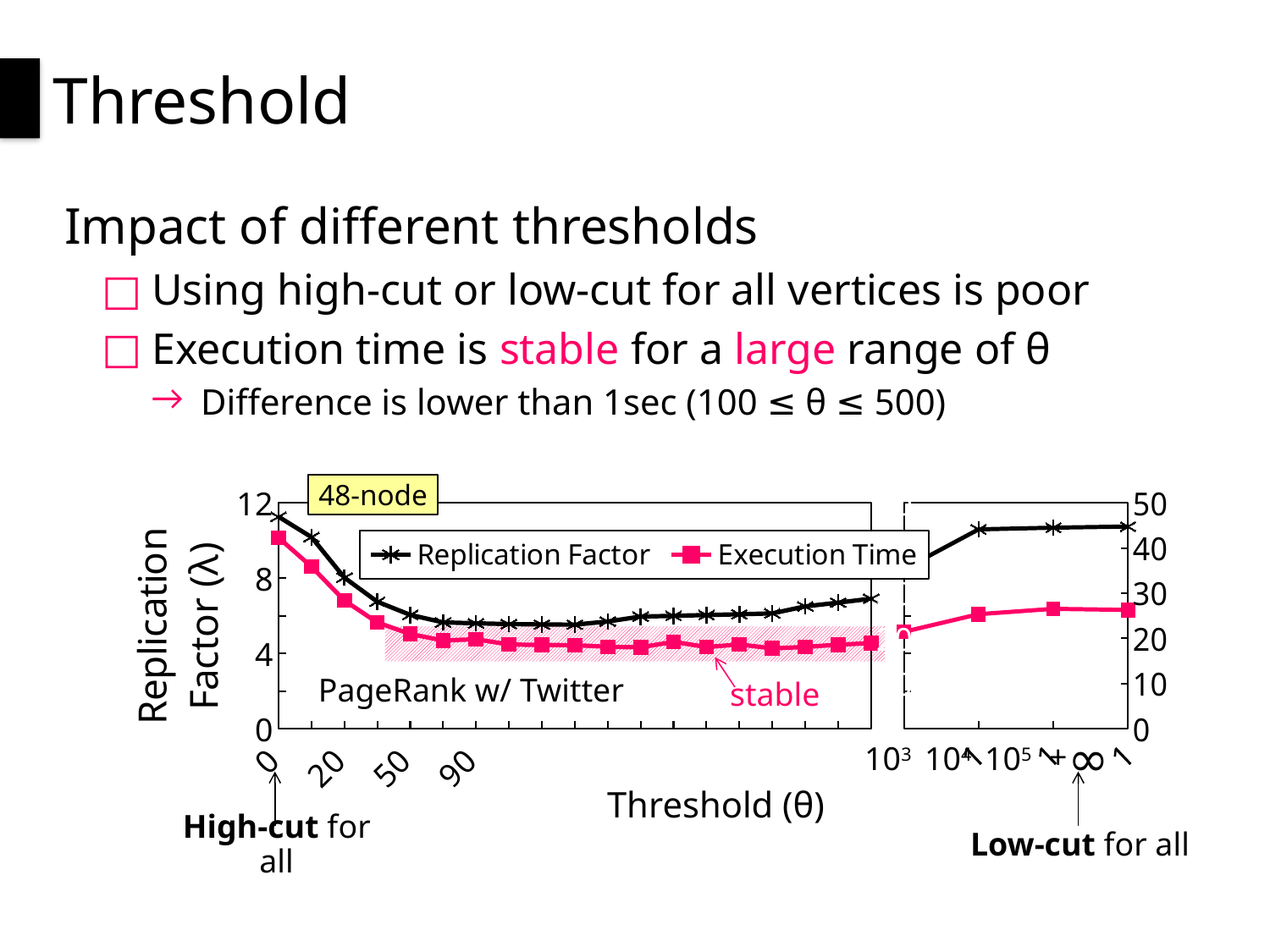
What kind of chart is shown on the slide? line chart What is the label of the x axis of the chart? Threshold (θ) Is the Replication Factor at threshold 50 greater or less than 8? less Does the Replication Factor rise or fall as the threshold increases from 0 to 50? fall How many series does the chart's legend list? 2 Is the Replication Factor at threshold 0 greater or less than 8? greater Is the Execution Time at threshold 90 greater or less than 30 on the right axis? less Which is larger, the Replication Factor at threshold 0 or at threshold 50? threshold 0 Does the Execution Time rise or fall as the threshold increases from 0 to 50? fall What are the two series named in the chart's legend? Replication Factor and Execution Time